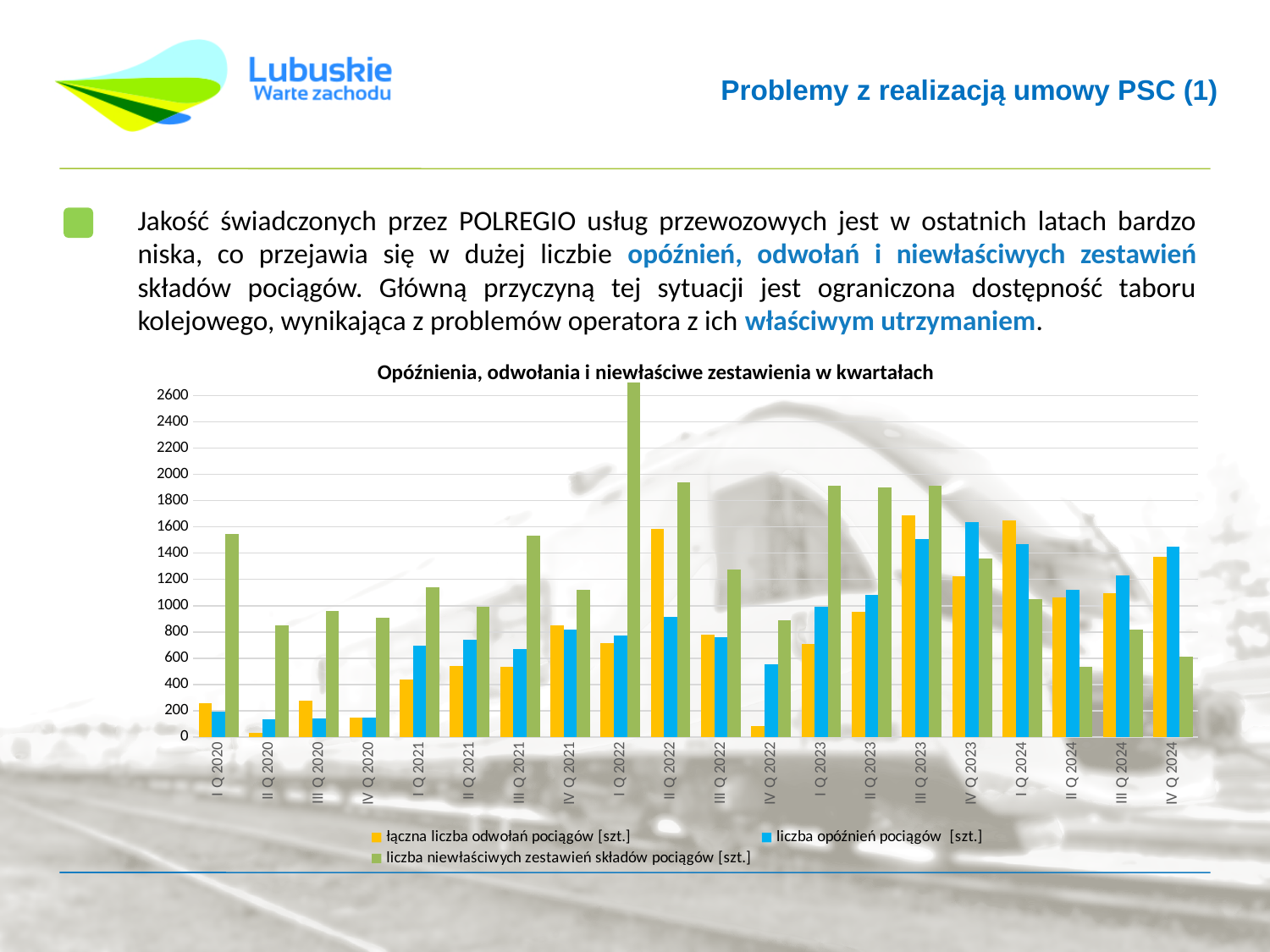
In which quarter is the value for 'łączna liczba odwołań pociągów [szt.]' the lowest? II Q 2020 Is the value for 'łączna liczba odwołań pociągów [szt.]' in IV Q 2022 greater or less than 200? less Does the value for 'liczba opóźnień pociągów [szt.]' generally rise or fall from I Q 2020 to IV Q 2023? rise What kind of chart is shown on the slide? bar chart Which colour represents the series 'liczba niewłaściwych zestawień składów pociągów [szt.]'? green How many series does the chart legend list? 3 How many quarters are shown on the x axis of the chart? 20 In which quarter is the value for 'liczba niewłaściwych zestawień składów pociągów [szt.]' the highest? I Q 2022 In I Q 2023, which is larger: 'liczba niewłaściwych zestawień składów pociągów [szt.]' or 'łączna liczba odwołań pociągów [szt.]'? liczba niewłaściwych zestawień składów pociągów [szt.] Is the value for 'liczba niewłaściwych zestawień składów pociągów [szt.]' in I Q 2020 greater or less than 1400? greater What is the title of the chart? Opóźnienia, odwołania i niewłaściwe zestawienia w kwartałach In which quarter is the value for 'liczba opóźnień pociągów [szt.]' the highest? IV Q 2023